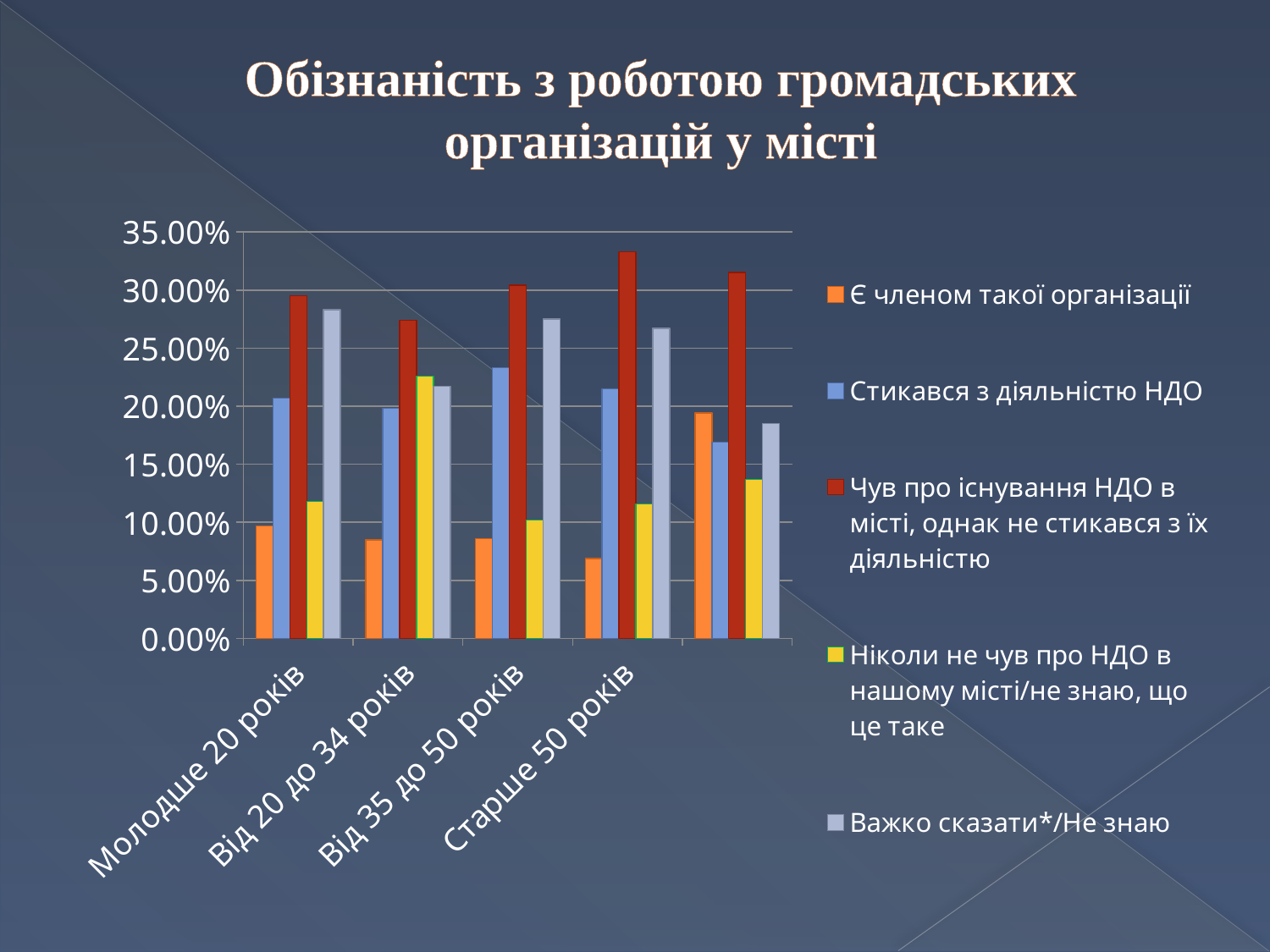
Is the value for "Є членом такої організації" in the "Молодше 20 років" group greater or less than 15.00%? less How many series does the legend list? 5 Is the value for "Ніколи не чув про НДО в нашому місті/не знаю, що це таке" in the "Від 20 до 34 років" group greater or less than 20.00%? greater In the "Молодше 20 років" group, which is larger: "Стикався з діяльністю НДО" or "Ніколи не чув про НДО в нашому місті/не знаю, що це таке"? Стикався з діяльністю НДО Which series has the highest value in the "Старше 50 років" group? Чув про існування НДО в місті, однак не стикався з їх діяльністю What is the title of the chart? Обізнаність з роботою громадських організацій у місті Is the value for "Важко сказати*/Не знаю" in the "Молодше 20 років" group greater or less than 25.00%? greater Which series has the lowest value in the "Старше 50 років" group? Є членом такої організації In the "Від 35 до 50 років" group, which is larger: "Чув про існування НДО в місті, однак не стикався з їх діяльністю" or "Важко сказати*/Не знаю"? Чув про існування НДО в місті, однак не стикався з їх діяльністю Which series has the lowest value in the "Від 20 до 34 років" group? Є членом такої організації What kind of chart is shown on the slide? Bar chart